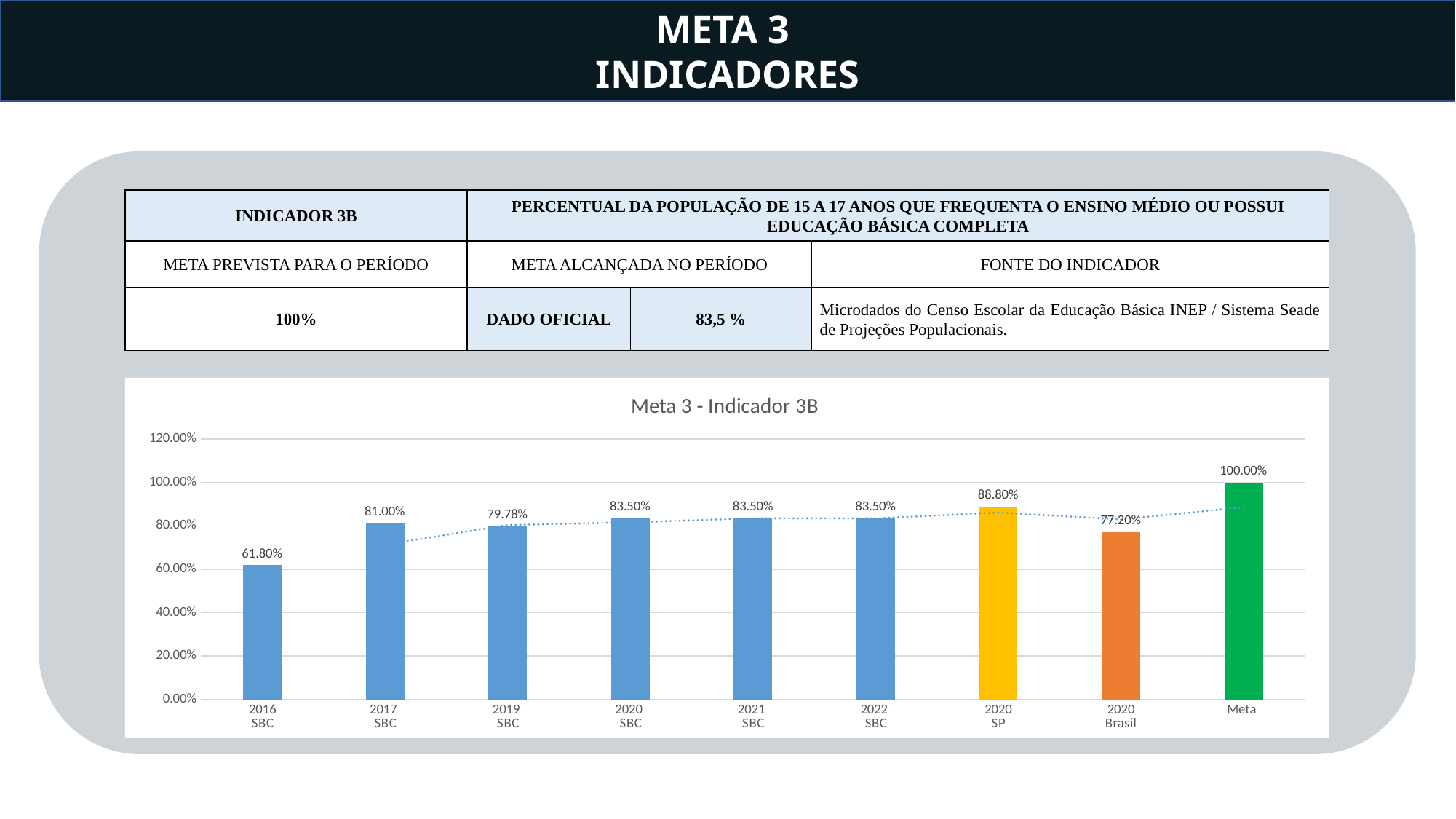
Which category has the lowest value in the chart? 2016 SBC What is the value for 2019 SBC in the chart? 79.78% Do the SBC values rise or fall from 2016 to 2020? Rise Which category has the highest value in the chart? Meta What is the title of the chart? Meta 3 - Indicador 3B How many bars are plotted in the chart? 9 Which is larger, the value for 2017 SBC or the value for 2019 SBC? 2017 SBC What is the value for 2020 SP in the chart? 88.80% What kind of chart is shown on the slide? Bar chart What is the value for 2016 SBC in the Meta 3 - Indicador 3B chart? 61.80% What is the difference between the values for 2020 SP and 2020 Brasil? 11.60% What is the value for 2020 Brasil in the chart? 77.20%